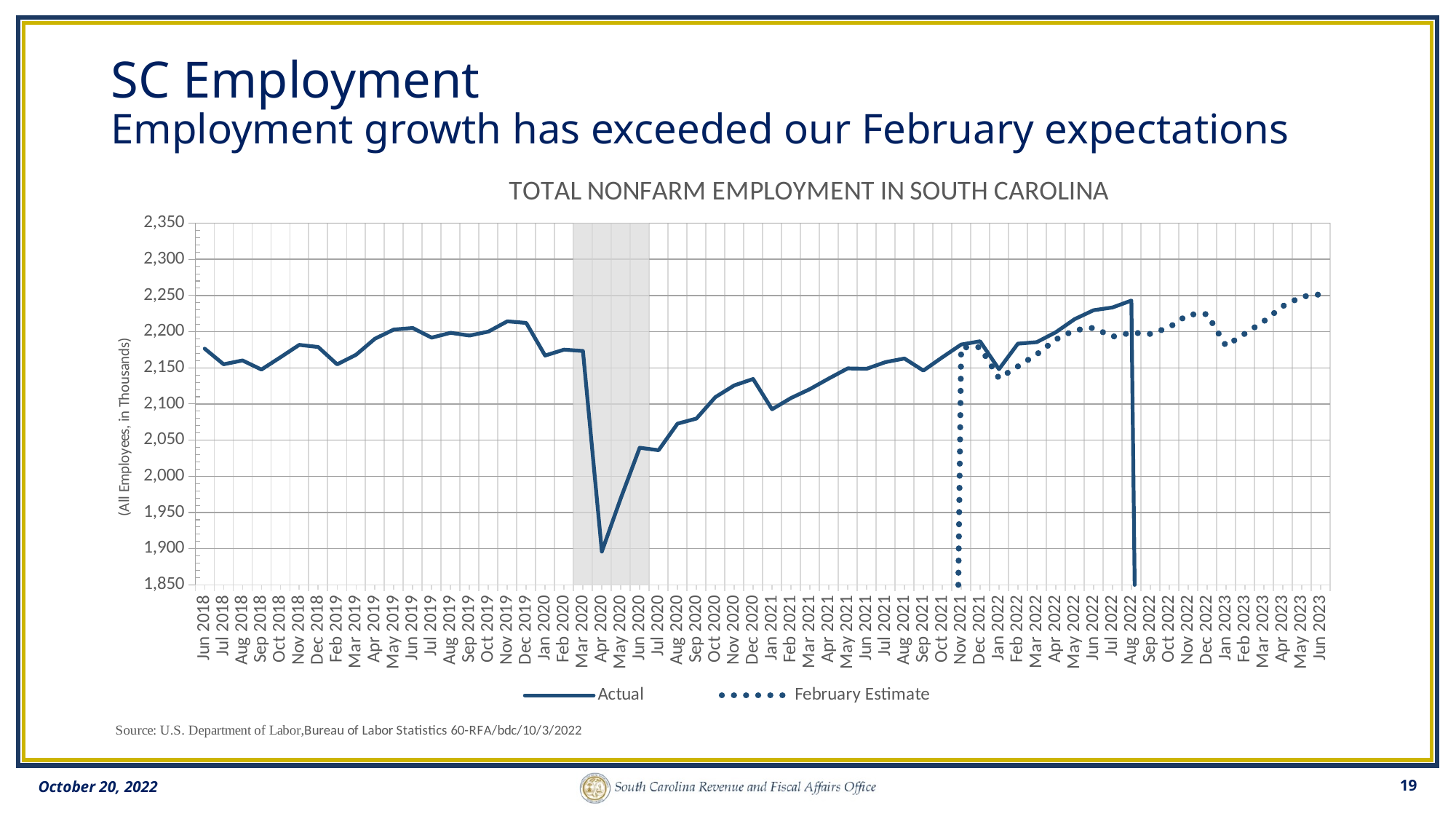
Is the Actual value for Aug 2022 greater or less than 2,200? greater In which month does the Actual series reach its lowest value? Apr 2020 How many series does the legend list? 2 What is the title of the chart? TOTAL NONFARM EMPLOYMENT IN SOUTH CAROLINA Is the Actual value for Nov 2019 greater or less than 2,200? greater Does the Actual series generally rise or fall from Apr 2020 to Aug 2022? Rise Is the Actual value for Apr 2020 greater or less than 1,950? less For Aug 2022, which is larger: the Actual value or the February Estimate value? Actual What kind of chart is shown on the slide? Line chart Which series is drawn with a dotted line in the chart? February Estimate